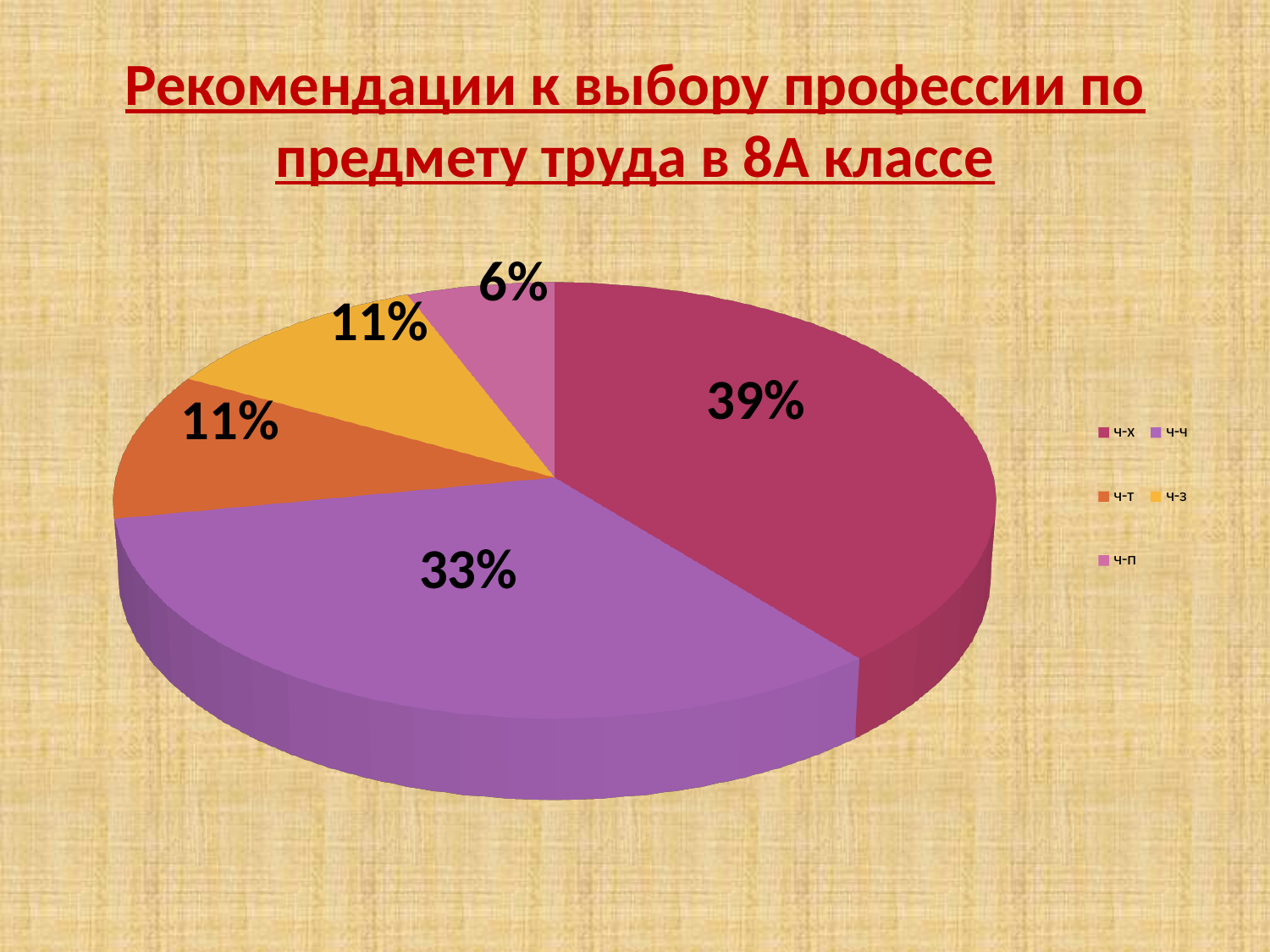
How many entries does the legend list? 5 What is the difference in percentage points between the ч-х slice and the ч-ч slice? 6 Which category has the largest slice of the pie? ч-х Which category has the smallest slice of the pie? ч-п What share of the pie does the ч-з slice represent? 11% How many slices does the pie chart have? 5 What is the title of the chart on the slide? Рекомендации к выбору профессии по предмету труда в 8А классе What share of the pie does the ч-п slice represent? 6% What share of the pie does the ч-ч slice represent? 33% What kind of chart is shown on the slide? pie chart Which slice is larger, ч-ч or ч-т? ч-ч